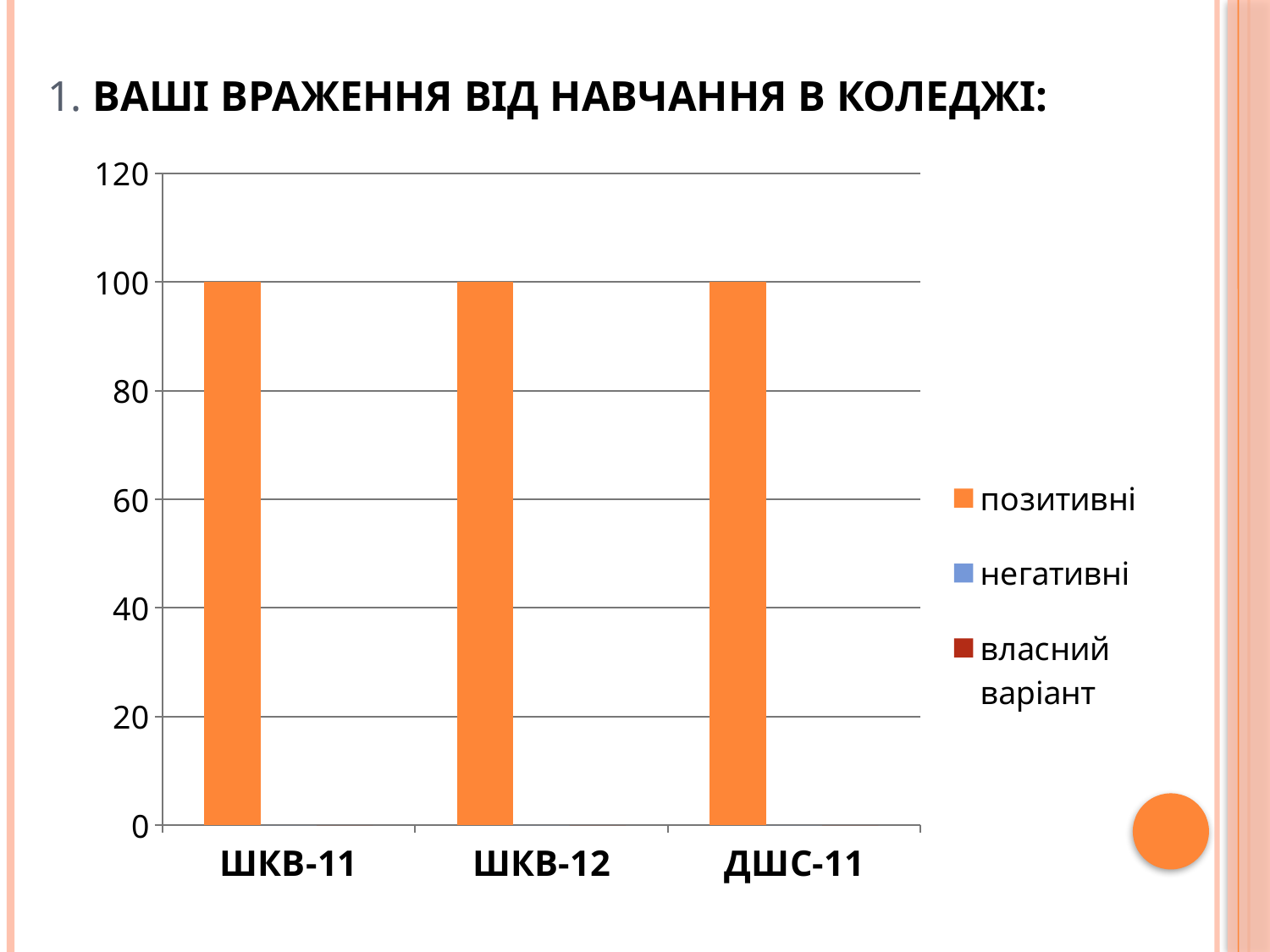
What is the value of the позитивні bar for ДШС-11? 100 What kind of chart is shown on the slide? bar chart Which legend entry is shown in orange? позитивні What is the value of the позитивні bar for ШКВ-12? 100 Is the value for ДШС-11 greater or less than 120? less What is the difference between the позитивні values for ШКВ-11 and ДШС-11? 0 How many categories are shown on the x axis of the chart? 3 How many series does the chart legend list? 3 What is the title of the chart on the slide? ВАШІ ВРАЖЕННЯ ВІД НАВЧАННЯ В КОЛЕДЖІ: What is the value of the позитивні bar for ШКВ-11? 100 Is the value for ШКВ-12 greater or less than 80? greater Do the позитивні values rise, fall, or stay the same across the categories from ШКВ-11 to ДШС-11? stay the same